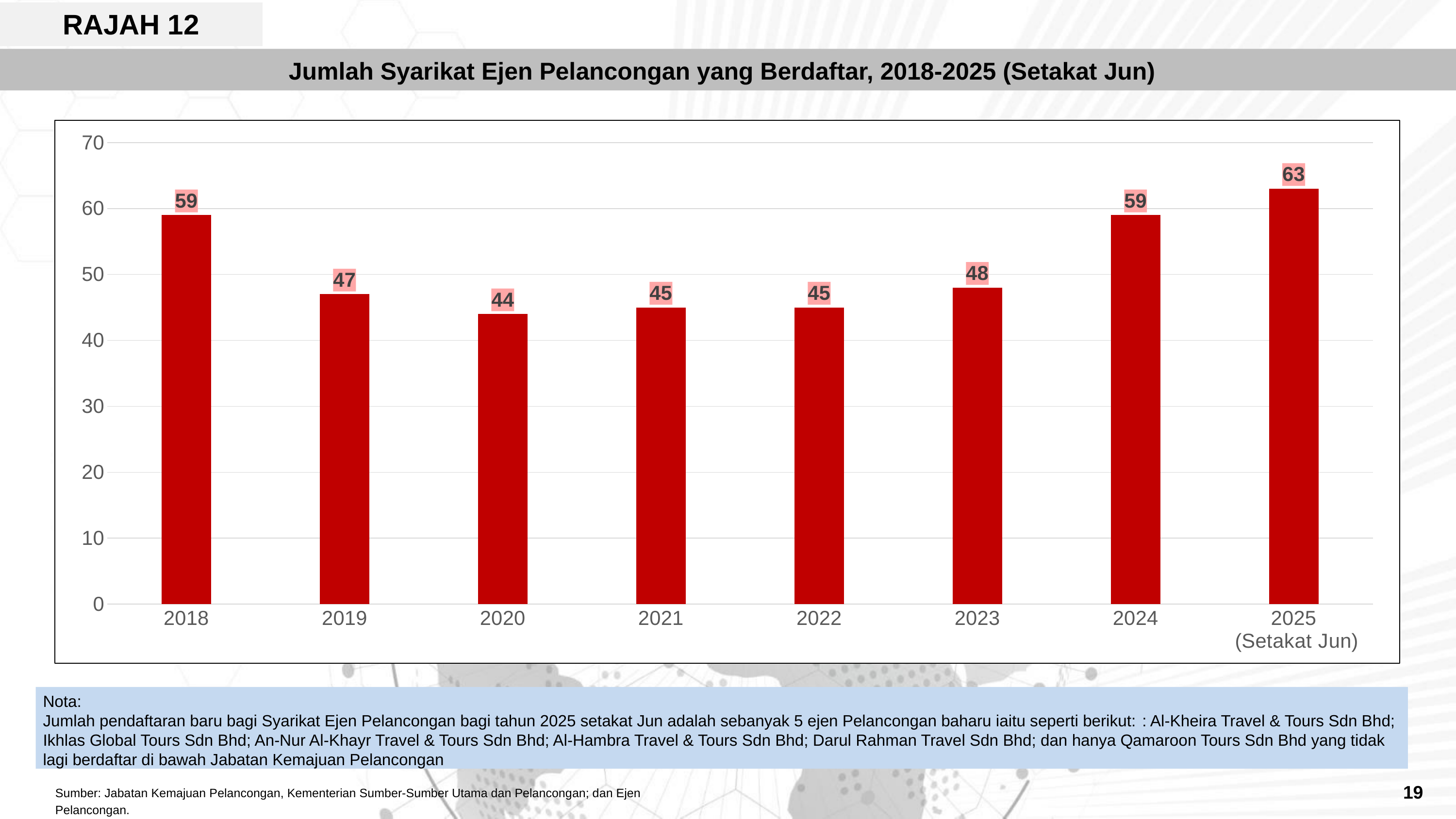
What kind of chart is shown? bar chart Which year has the lowest value? 2020 Which is larger, the value for 2023 or the value for 2022? 2023 What is the difference between the values for 2025 (Setakat Jun) and 2024? 4 What is the value for 2020? 44 What is the value for 2025 (Setakat Jun)? 63 Which year has the highest value? 2025 (Setakat Jun) How many years are shown on the x axis? 8 What is the title of the chart? Jumlah Syarikat Ejen Pelancongan yang Berdaftar, 2018-2025 (Setakat Jun) What is the value for 2018? 59 What is the value for 2023? 48 What is the difference between the values for 2018 and 2019? 12